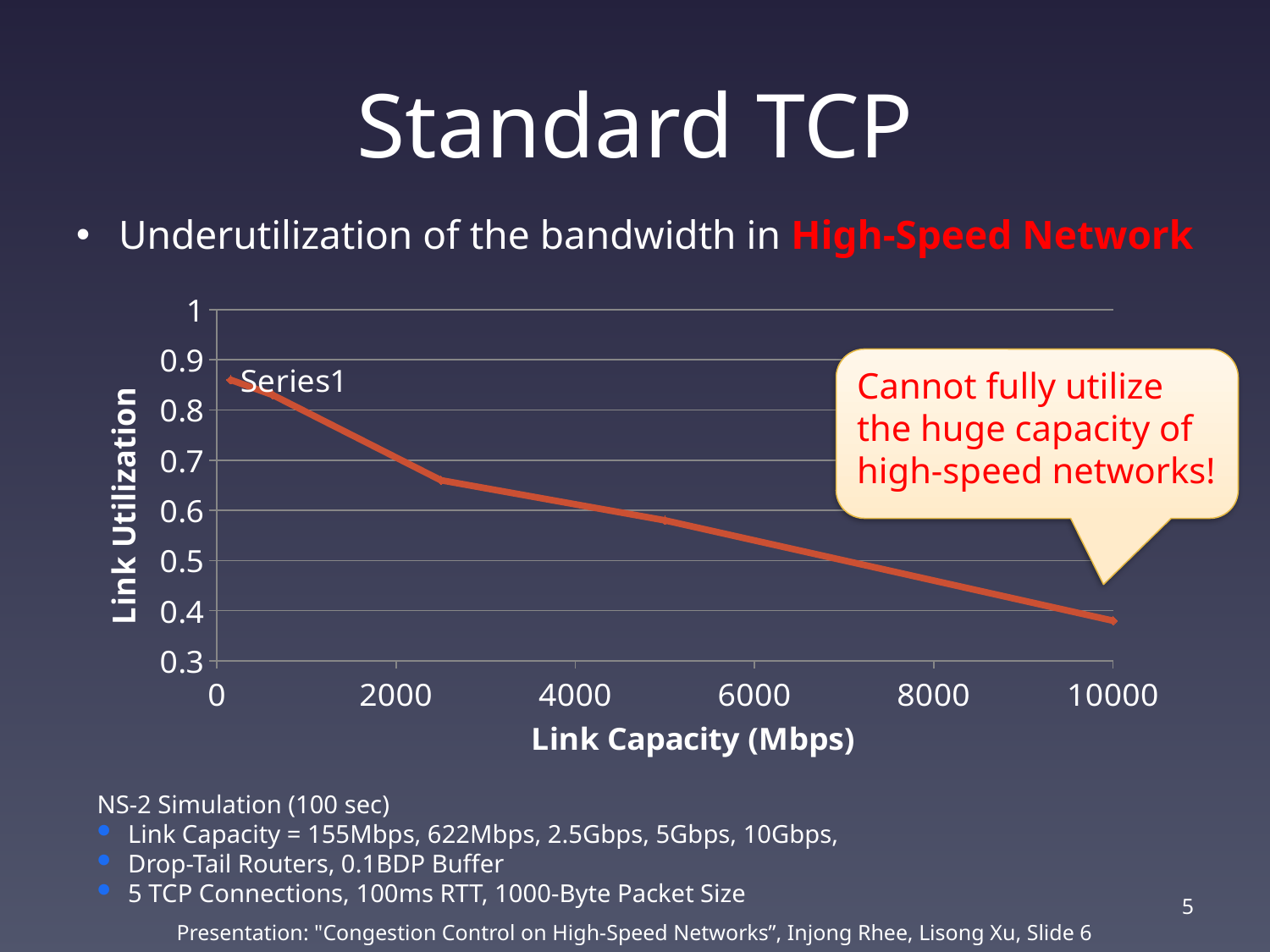
What is the title of the x axis? Link Capacity (Mbps) Is the link utilization at a link capacity of about 5000 Mbps greater or less than 0.7? less What kind of chart is shown on the slide? line chart At which end of the x axis is link utilization highest? the lowest link capacity (leftmost point) At which end of the x axis is link utilization lowest? 10000 Mbps Is the link utilization at a link capacity of 10000 Mbps greater or less than 0.5? less Is the link utilization at a link capacity of about 2500 Mbps greater or less than 0.6? greater Which has the higher link utilization: a link capacity of about 2500 Mbps or 10000 Mbps? 2500 Mbps Does link utilization rise or fall as link capacity increases along the x axis? fall What is the name of the series shown in the chart? Series1